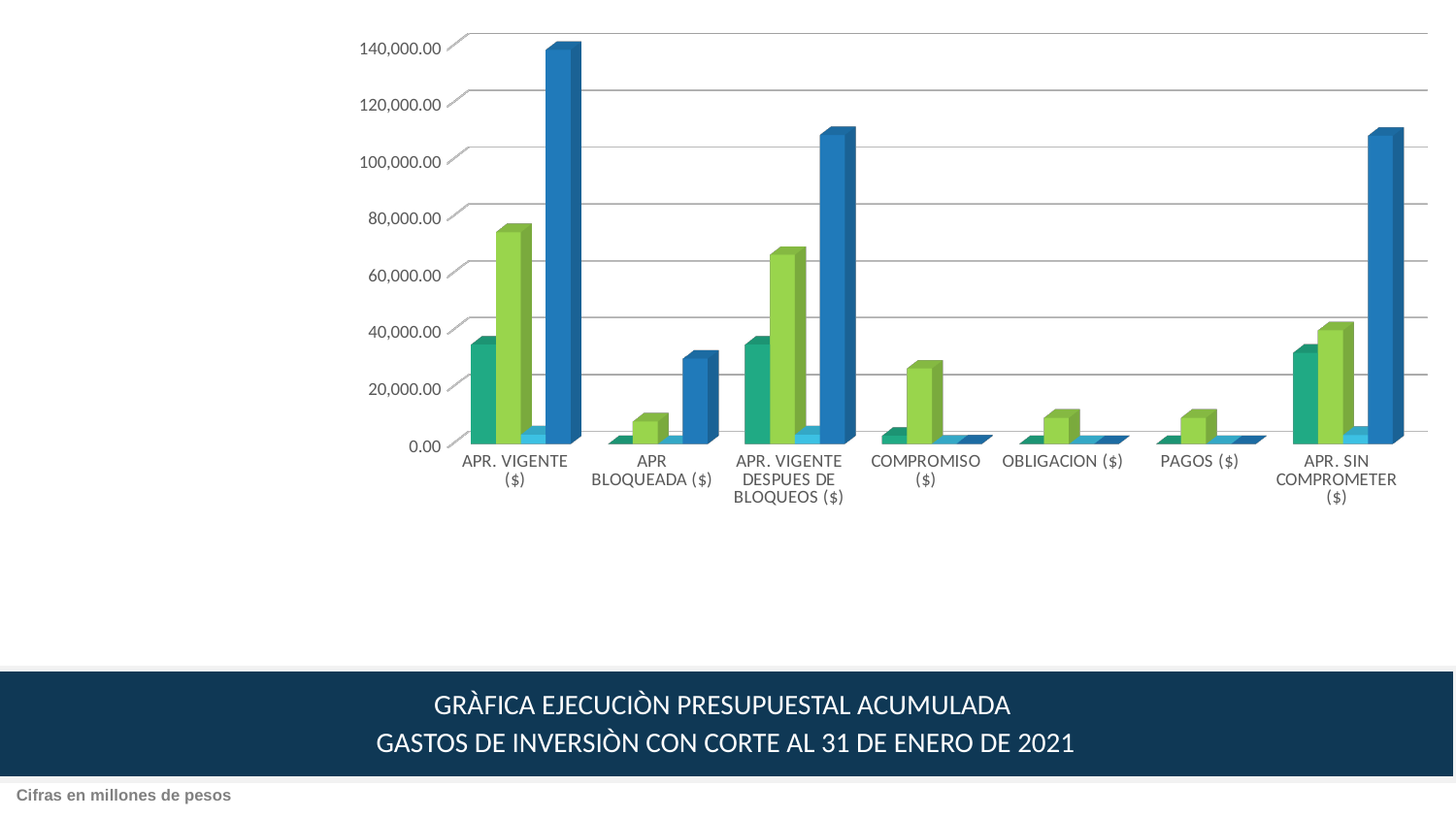
Is the dark blue bar for APR BLOQUEADA ($) greater or less than 40,000.00? less What kind of chart is shown on the slide? bar chart Is the light green bar for APR. VIGENTE ($) greater or less than 60,000.00? greater How many categories are shown on the x axis of the chart? 7 Is the dark blue bar for APR. VIGENTE ($) greater or less than 120,000.00? greater Which has the taller light green bar: APR. VIGENTE ($) or APR. SIN COMPROMETER ($)? APR. VIGENTE ($) Which category contains the tallest bar in the chart? APR. VIGENTE ($) Which has the taller dark blue bar: APR. VIGENTE ($) or APR. VIGENTE DESPUES DE BLOQUEOS ($)? APR. VIGENTE ($) What is the highest value labelled on the chart's vertical axis? 140,000.00